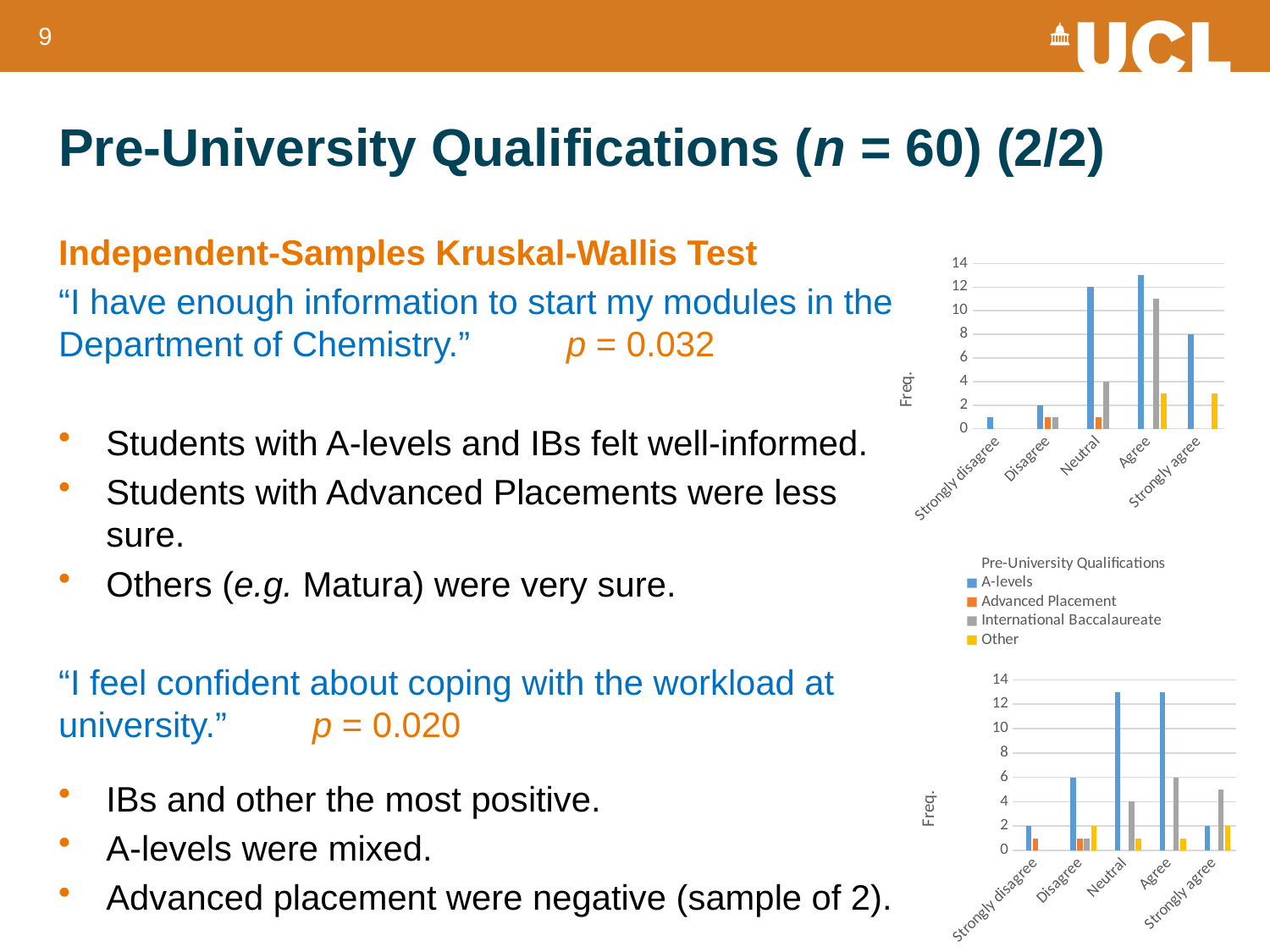
In the top chart, what is the difference between the A-levels and International Baccalaureate frequencies for Neutral? 8 In the top chart, which category has the highest International Baccalaureate bar? Agree In the top chart, is the A-levels value for Agree greater or less than 10? greater In the top chart, what is the frequency for International Baccalaureate in the Neutral category? 4 How many series does the legend list for the charts? 4 In the bottom chart, is the A-levels value for Neutral greater or less than 10? greater What is the title of the legend shared by the charts? Pre-University Qualifications How many categories are shown on the x axis of the bottom chart? 5 What type of chart is the top chart on the slide? bar chart In the bottom chart, what is the frequency for A-levels in the Disagree category? 6 In the top chart, what is the frequency for A-levels in the Neutral category? 12 In the top chart, what is the frequency for A-levels in the Strongly agree category? 8